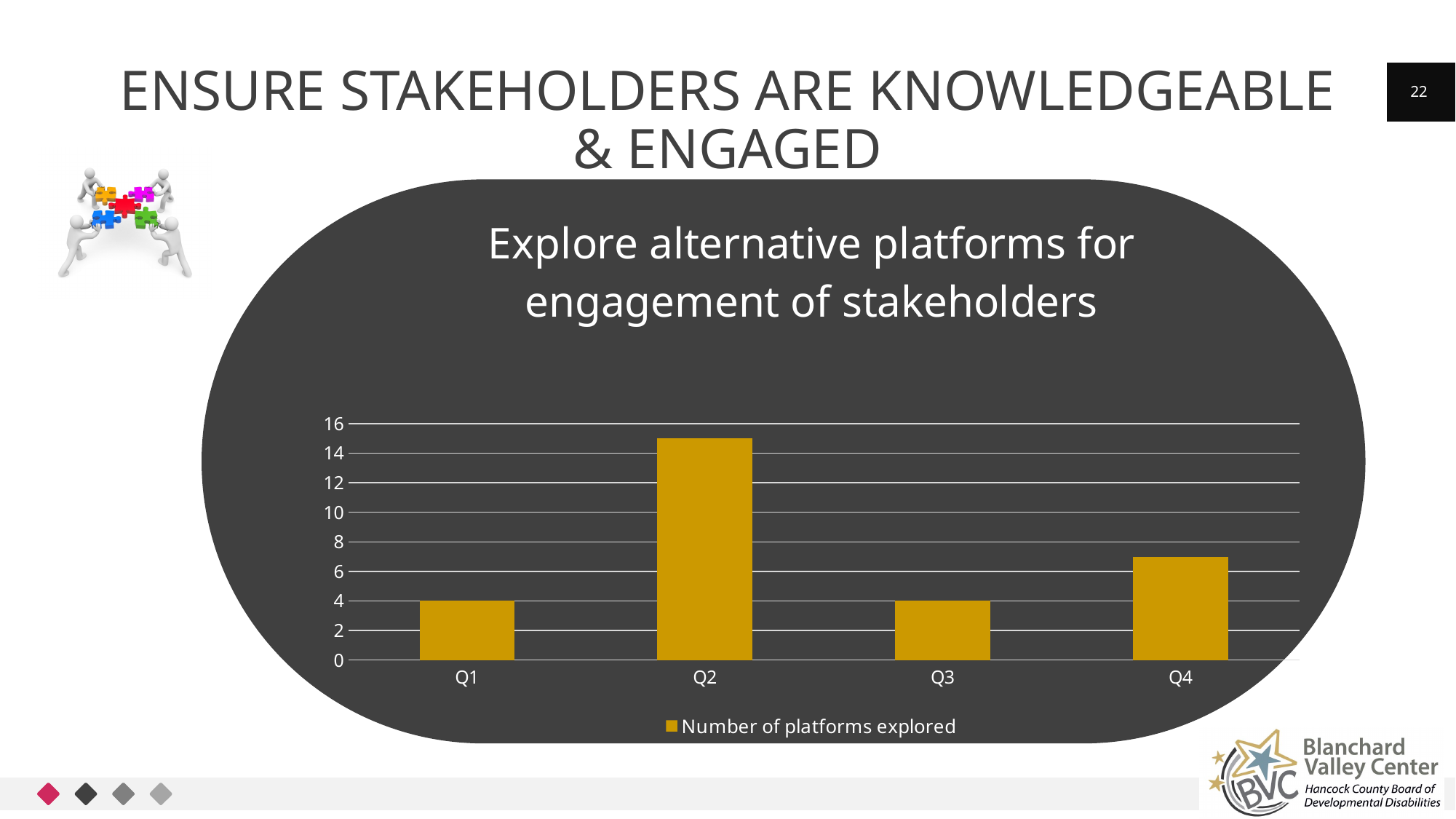
How many quarters are shown on the x axis? 4 Is the value for Q4 greater or less than 8? less Is the value for Q4 greater or less than 6? greater What type of chart is shown on the slide? Bar chart Which is larger, the value for Q4 or the value for Q1? Q4 What is the legend entry for the series shown in the chart? Number of platforms explored What is the value for Q3? 4 What is the difference between the values for Q1 and Q3? 0 Which quarter has the highest number of platforms explored? Q2 Is the value for Q2 greater or less than 14? greater What is the value for Q1? 4 How many series does the legend list? 1